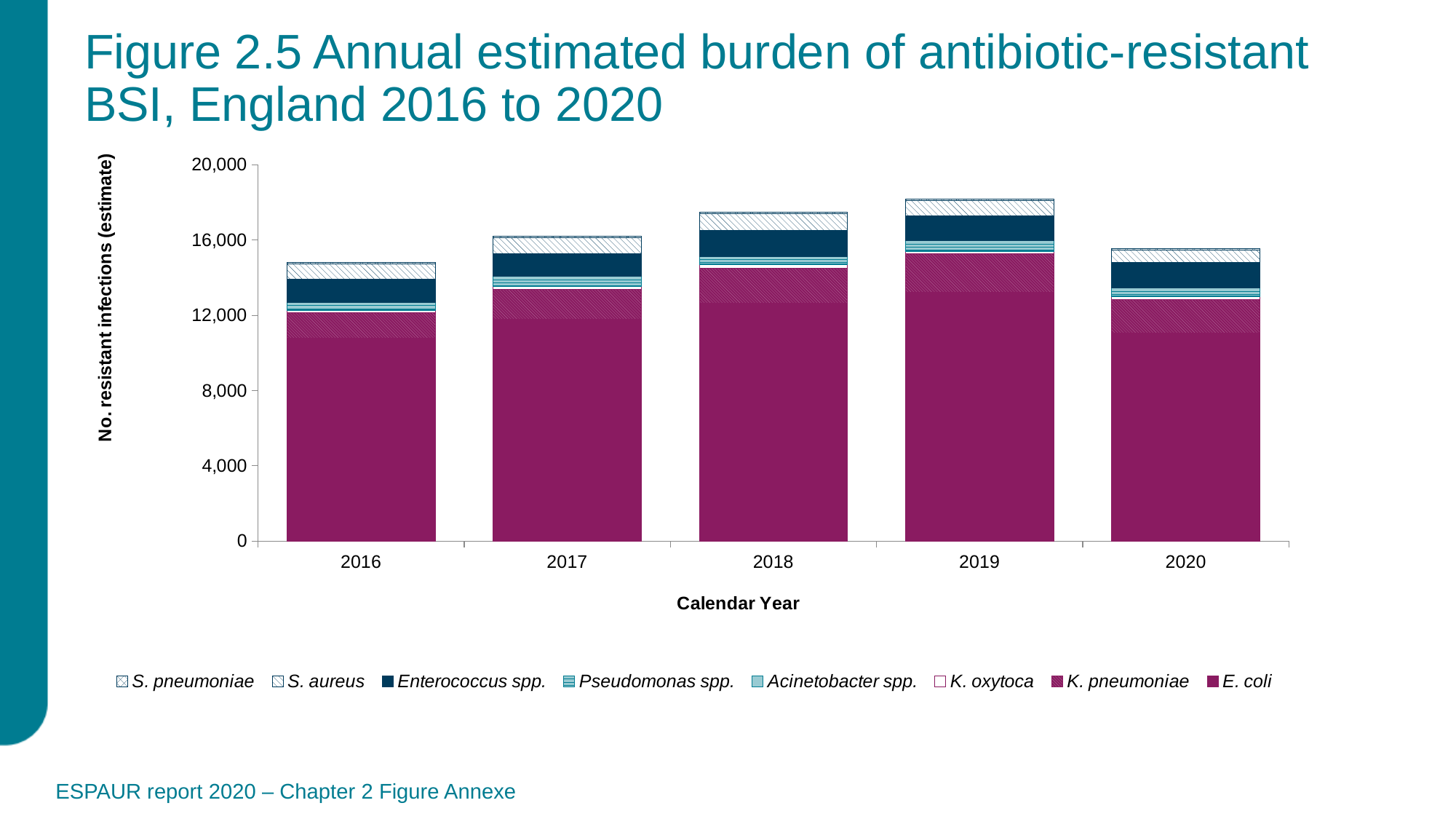
What is the label of the y axis? No. resistant infections (estimate) How many series does the legend list? 8 What kind of chart is shown on the slide? Stacked bar chart Which year has the larger total bar, 2017 or 2020? 2017 Is the total bar for 2016 greater or less than 16,000? less Which year has the lowest total estimated number of resistant infections? 2016 Which year has the highest total estimated number of resistant infections? 2019 Is the total bar for 2020 greater or less than 16,000? less Is the total bar for 2019 greater or less than 16,000? greater How many calendar years are shown on the x axis? 5 How does the total estimated burden change from 2016 to 2019? It rises each year